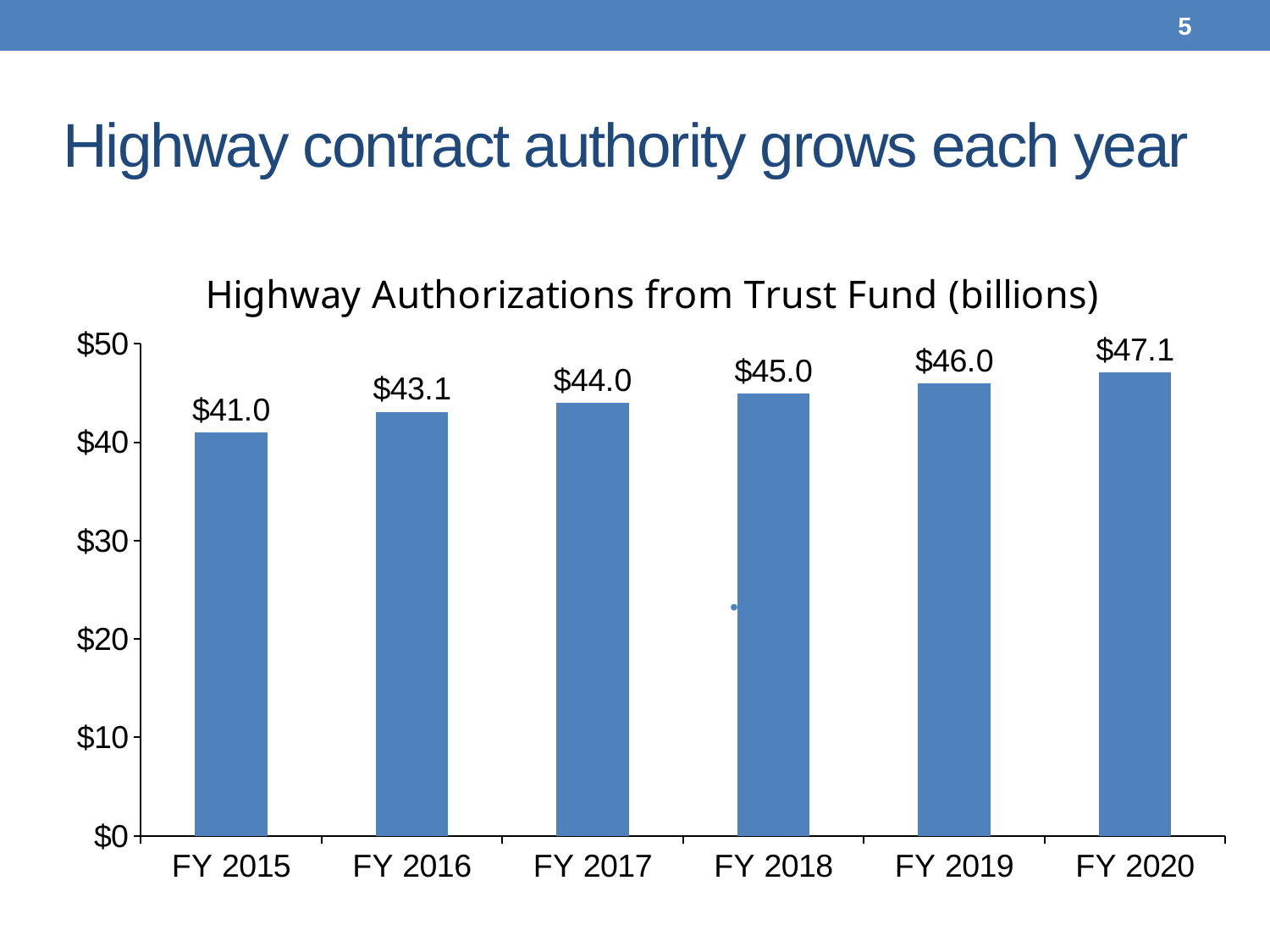
Which is larger, the value for FY 2017 or FY 2019? FY 2019 Which fiscal year has the highest value? FY 2020 What is the value for FY 2018? $45.0 How many fiscal years are shown on the chart? 6 What is the difference between the values for FY 2016 and FY 2015? $2.1 Which fiscal year has the lowest value? FY 2015 Is the value for FY 2016 greater or less than $40? greater Do the values rise or fall from FY 2015 to FY 2020? rise What is the value for FY 2020? $47.1 What is the value for FY 2015? $41.0 What kind of chart is shown on the slide? bar chart What is the difference between the values for FY 2020 and FY 2015? $6.1